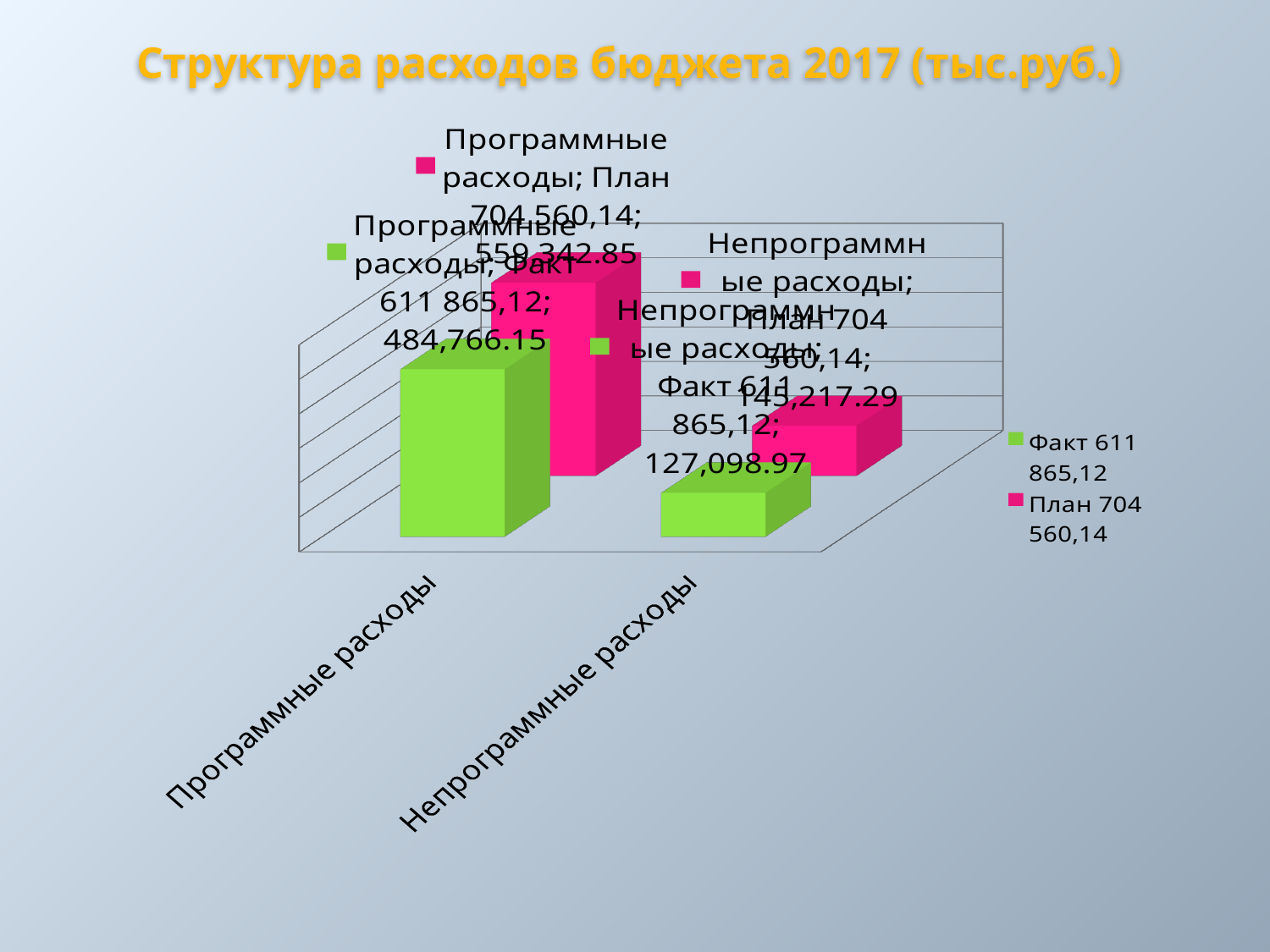
What is the Факт value for Программные расходы? 484,766.15 Which category has the highest План value? Программные расходы What is the title of the chart? Структура расходов бюджета 2017 (тыс.руб.) How many series does the legend list? 2 What is the План value for Непрограммные расходы? 145,217.29 Which is larger for Программные расходы: the План value or the Факт value? План How many categories are shown on the x axis? 2 What type of chart is shown on the slide? bar chart What colour are the bars for the Факт series? green What is the Факт value for Непрограммные расходы? 127,098.97 What is the План value for Программные расходы? 559,342.85 Which category has the lowest Факт value? Непрограммные расходы